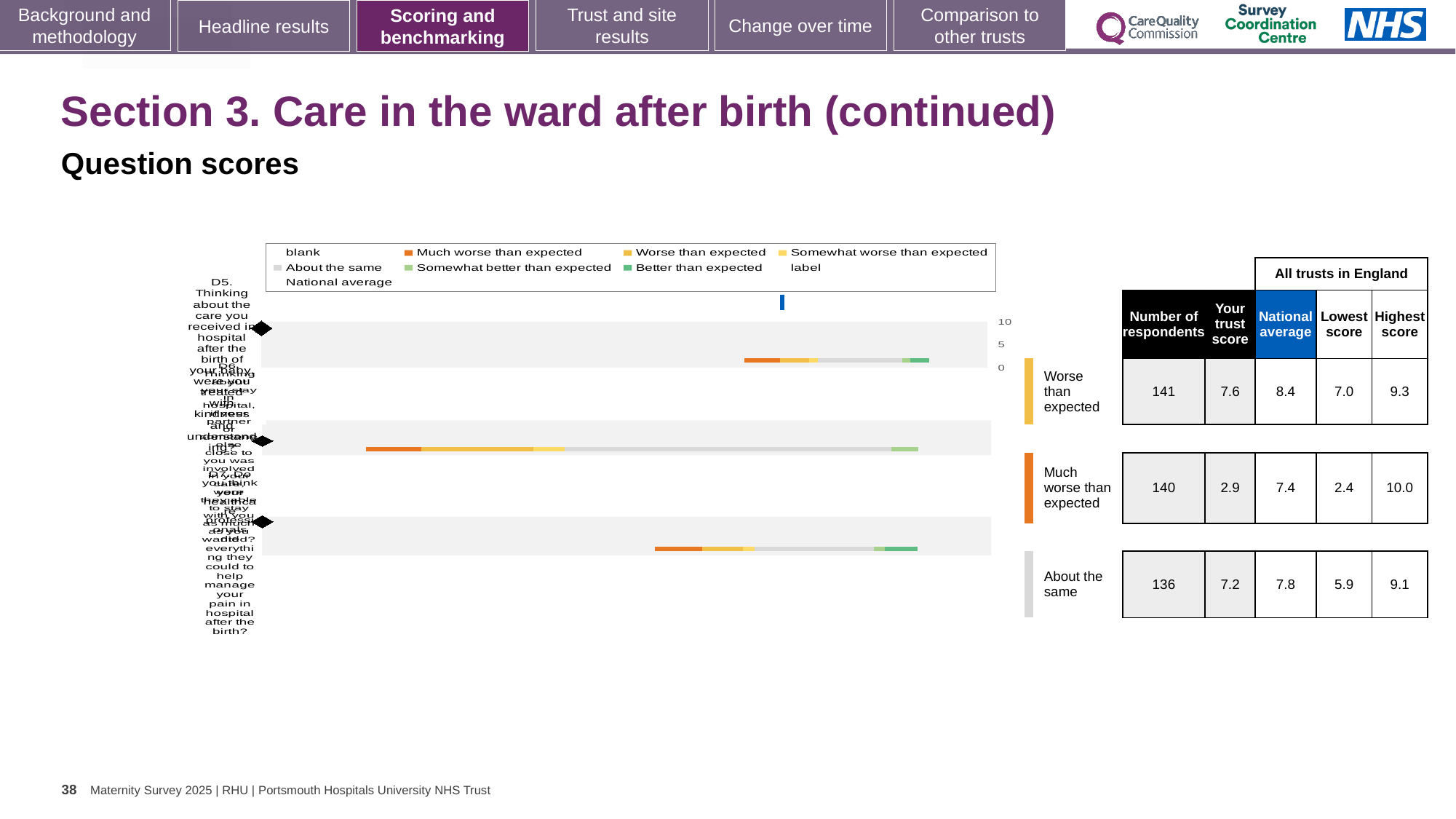
In the table beside the chart, what is the national average for the row rated 'About the same'? 7.8 What kind of chart is shown on the slide? bar chart In the table beside the chart, what is the trust score for the row rated 'Much worse than expected'? 2.9 In the table beside the chart, which row has the lowest trust score? Much worse than expected In the table beside the chart, what is the lowest score in England for the row rated 'About the same'? 5.9 How many question rows (bars) are plotted in the chart? 3 In the table beside the chart, which row has the highest number of respondents? Worse than expected In the table beside the chart, for the row rated 'About the same', which is larger: the trust score or the national average? national average In the table beside the chart, what is the difference between the national average and the trust score for the row rated 'Worse than expected'? 0.8 What colour in the chart legend represents 'Much worse than expected'? orange In the table beside the chart, what is the number of respondents for the row rated 'Worse than expected'? 141 In the table beside the chart, what is the highest score in England for the row rated 'Much worse than expected'? 10.0